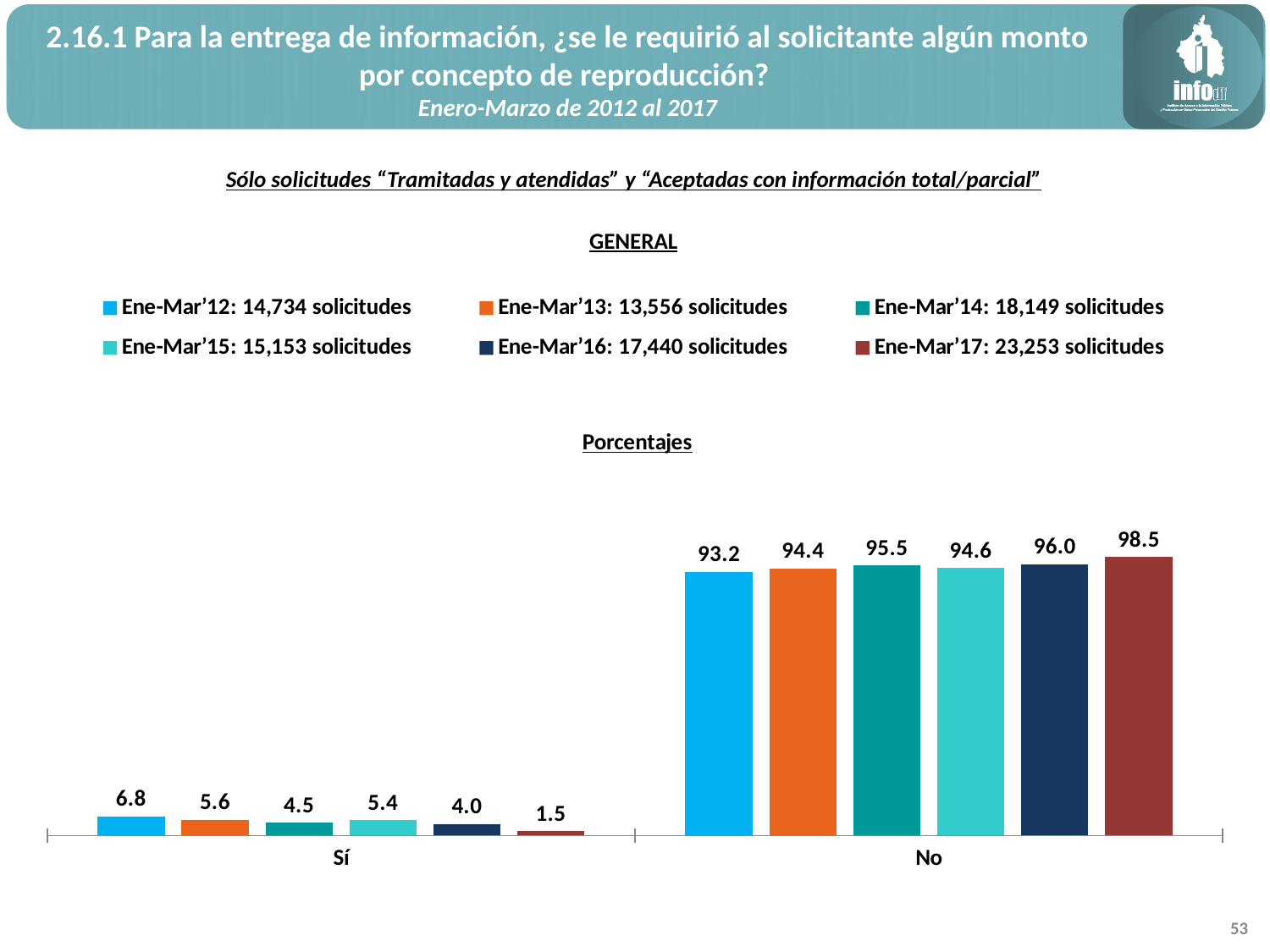
What is the value for Ene-Mar'12 in the Sí category? 6.8 What kind of chart is shown? bar chart What is the difference between the Ene-Mar'12 and Ene-Mar'17 values in the Sí category? 5.3 What is the difference between the Ene-Mar'16 and Ene-Mar'12 values in the No category? 2.8 How many solicitudes does the legend give for Ene-Mar'14? 18,149 solicitudes How many categories are shown on the x axis? 2 Which series has the lowest value in the Sí category? Ene-Mar'17 What is the value for Ene-Mar'15 in the No category? 94.6 How many series does the legend list? 6 Which is larger in the Sí category: Ene-Mar'13 or Ene-Mar'15? Ene-Mar'13 Which series has the highest value in the No category? Ene-Mar'17 What is the value for Ene-Mar'17 in the No category? 98.5